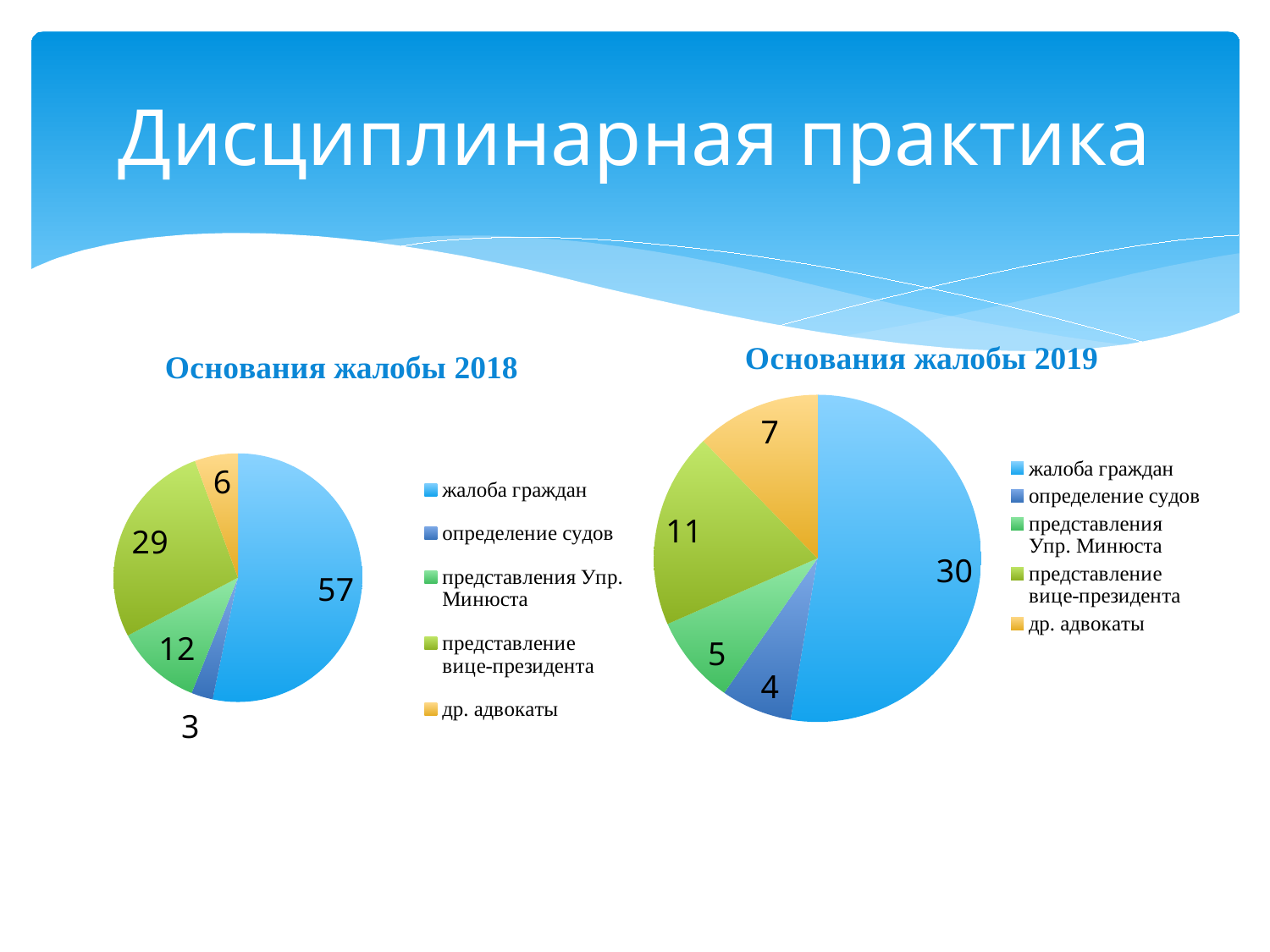
What is the total of all slices in the chart 'Основания жалобы 2019'? 57 In the chart 'Основания жалобы 2018', which category has the largest slice? жалоба граждан In the chart 'Основания жалобы 2019', which is larger: 'представления Упр. Минюста' or 'др. адвокаты'? др. адвокаты What kind of chart is 'Основания жалобы 2018'? pie chart In the chart 'Основания жалобы 2019', what is the value for 'др. адвокаты'? 7 How many categories does the chart 'Основания жалобы 2019' show? 5 In the chart 'Основания жалобы 2019', what is the value for 'представление вице-президента'? 11 In the chart 'Основания жалобы 2018', what is the value for 'жалоба граждан'? 57 How many charts are on the slide? 2 In the chart 'Основания жалобы 2018', what is the difference between 'представление вице-президента' and 'представления Упр. Минюста'? 17 In the chart 'Основания жалобы 2018', what is the value for 'определение судов'? 3 In the chart 'Основания жалобы 2019', which category has the smallest slice? определение судов